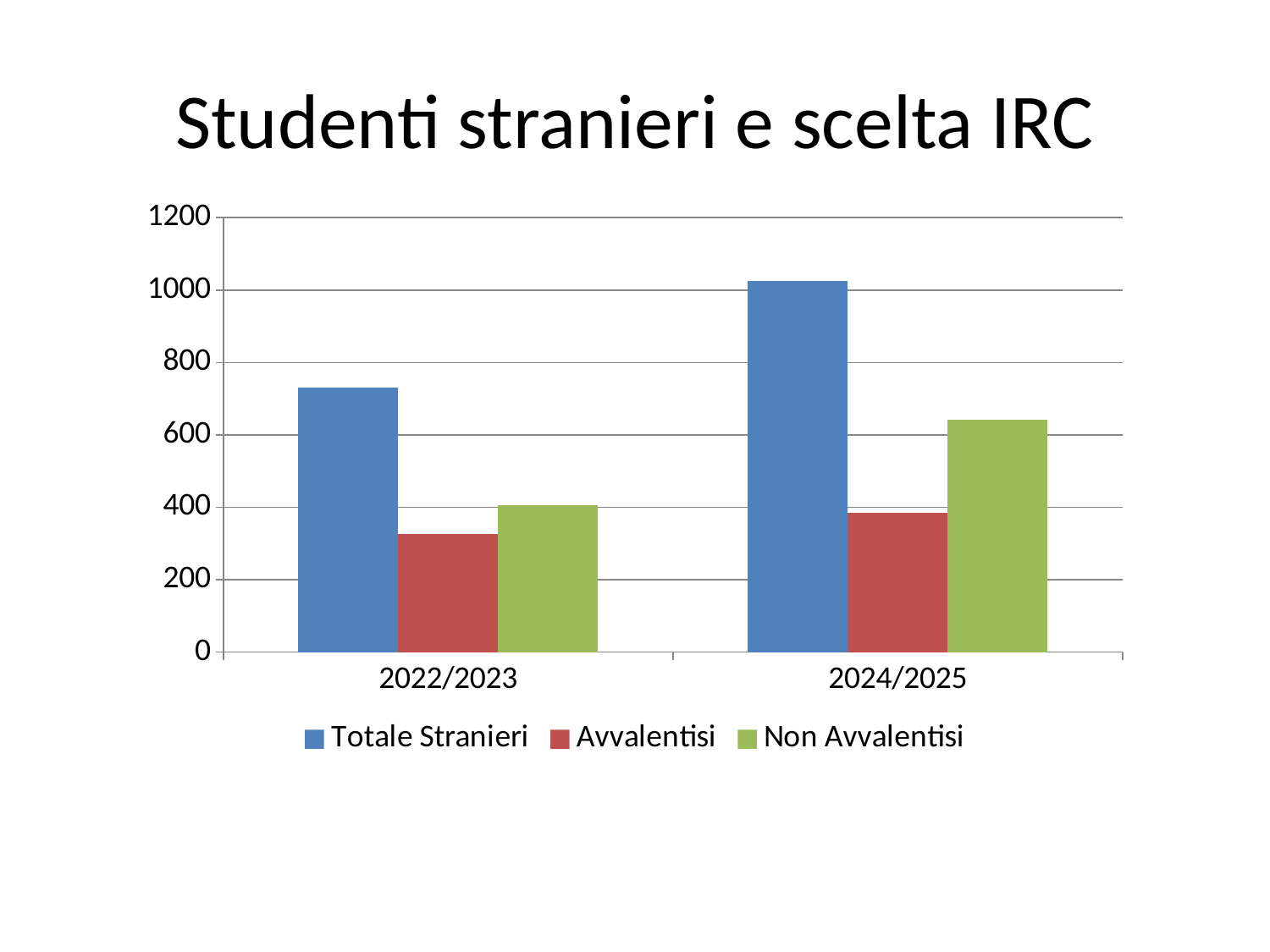
Is the value for Avvalentisi in 2022/2023 greater or less than 400? less Which series has the lowest bar in 2022/2023? Avvalentisi Which series has the highest bar in 2024/2025? Totale Stranieri Is the value for Totale Stranieri in 2022/2023 greater or less than 600? greater How many school-year categories are shown on the x axis? 2 Is the value for Non Avvalentisi in 2024/2025 greater or less than 600? greater What type of chart is shown on the slide? bar chart How many series does the legend list? 3 What is the title of the chart? Studenti stranieri e scelta IRC Does the Totale Stranieri value rise or fall from 2022/2023 to 2024/2025? rise Which is larger: Non Avvalentisi in 2024/2025 or Non Avvalentisi in 2022/2023? Non Avvalentisi in 2024/2025